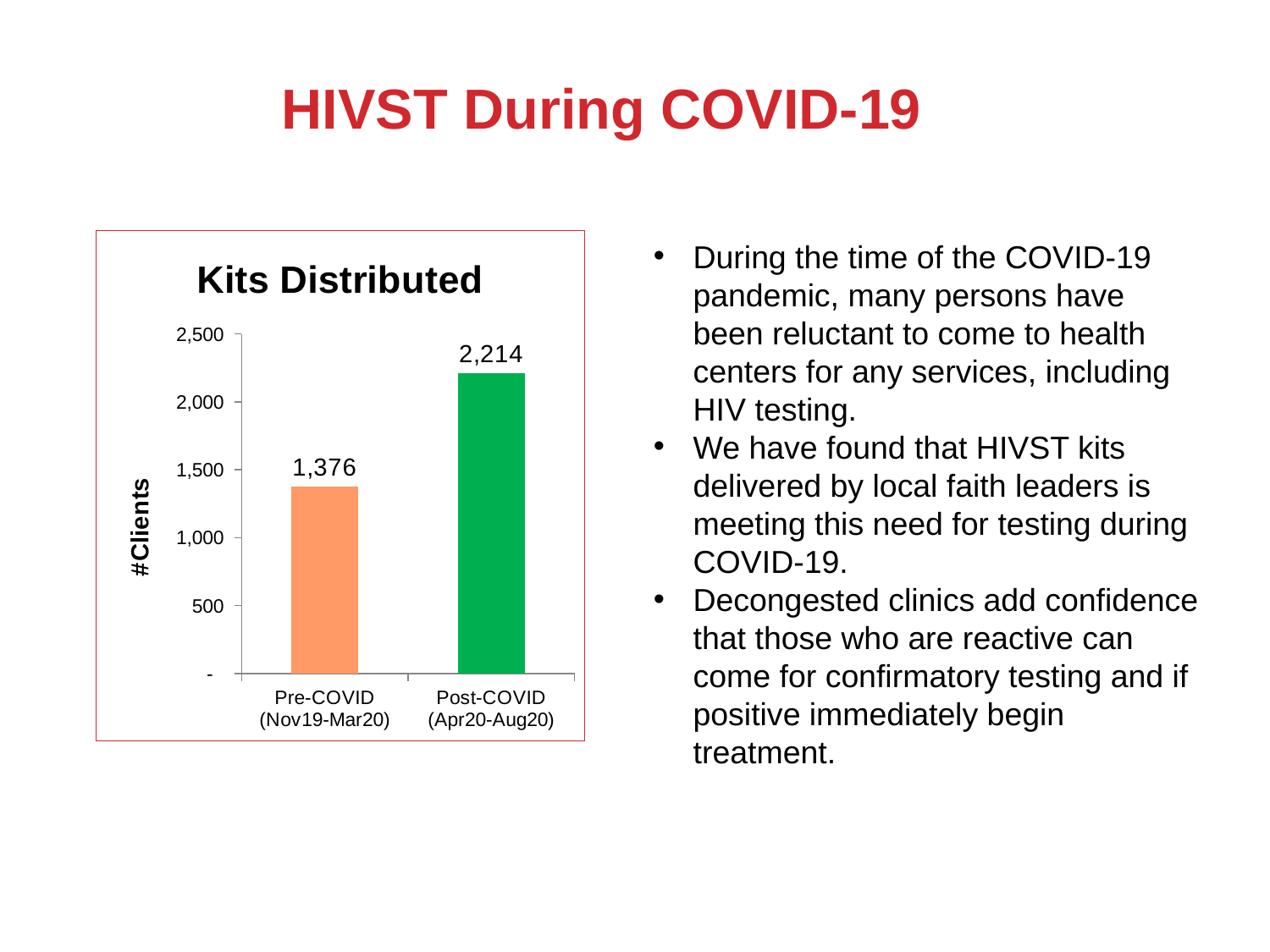
Is the value for Pre-COVID (Nov19-Mar20) greater or less than 1,500? less What kind of chart is the Kits Distributed chart? bar chart What is the y-axis label of the Kits Distributed chart? #Clients Do the values rise or fall from Pre-COVID to Post-COVID in the Kits Distributed chart? rise How many categories are shown in the Kits Distributed chart? 2 Is the value for Post-COVID (Apr20-Aug20) greater or less than 2,000? greater Which category has the highest value in the Kits Distributed chart? Post-COVID (Apr20-Aug20) Which is larger in the Kits Distributed chart: Pre-COVID or Post-COVID? Post-COVID What is the value for Post-COVID (Apr20-Aug20) in the Kits Distributed chart? 2,214 Which category has the lowest value in the Kits Distributed chart? Pre-COVID (Nov19-Mar20) What is the difference between the Post-COVID and Pre-COVID values in the Kits Distributed chart? 838 What is the value for Pre-COVID (Nov19-Mar20) in the Kits Distributed chart? 1,376